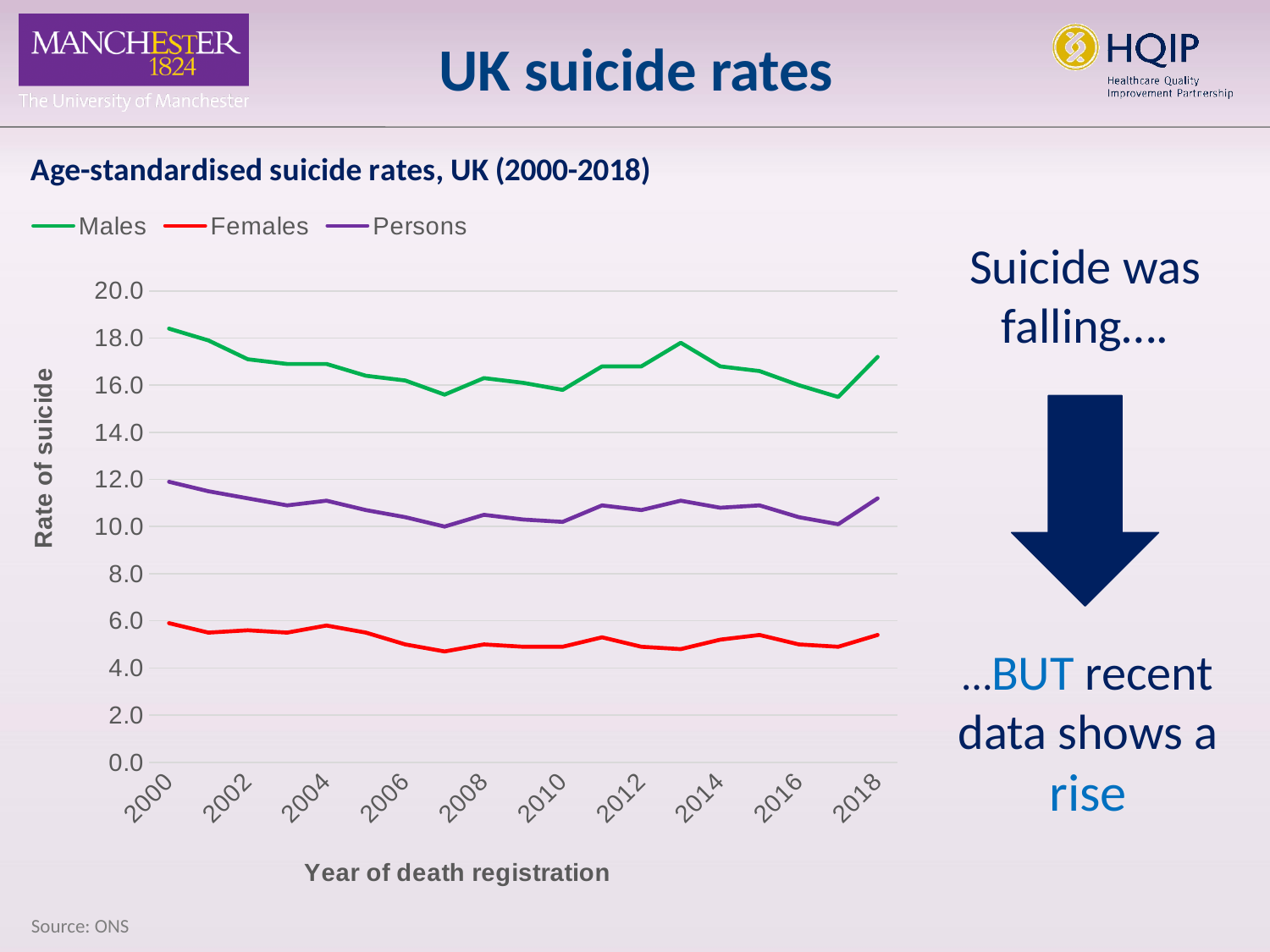
Is the value for Males in 2013 greater or less than 16.0? greater Which series has the highest rate of suicide across the chart? Males How many series does the legend list? 3 Is the value for Females in 2010 greater or less than 8.0? less What kind of chart is shown on the slide? Line chart Which series has the lowest rate of suicide across the chart? Females Is the value for Males in 2000 greater or less than 16.0? greater What is the title of the chart? Age-standardised suicide rates, UK (2000-2018) In 2018, which is larger, the rate for Males or the rate for Females? Males Does the Males line rise or fall between 2000 and 2007? Fall What is the label of the x axis? Year of death registration